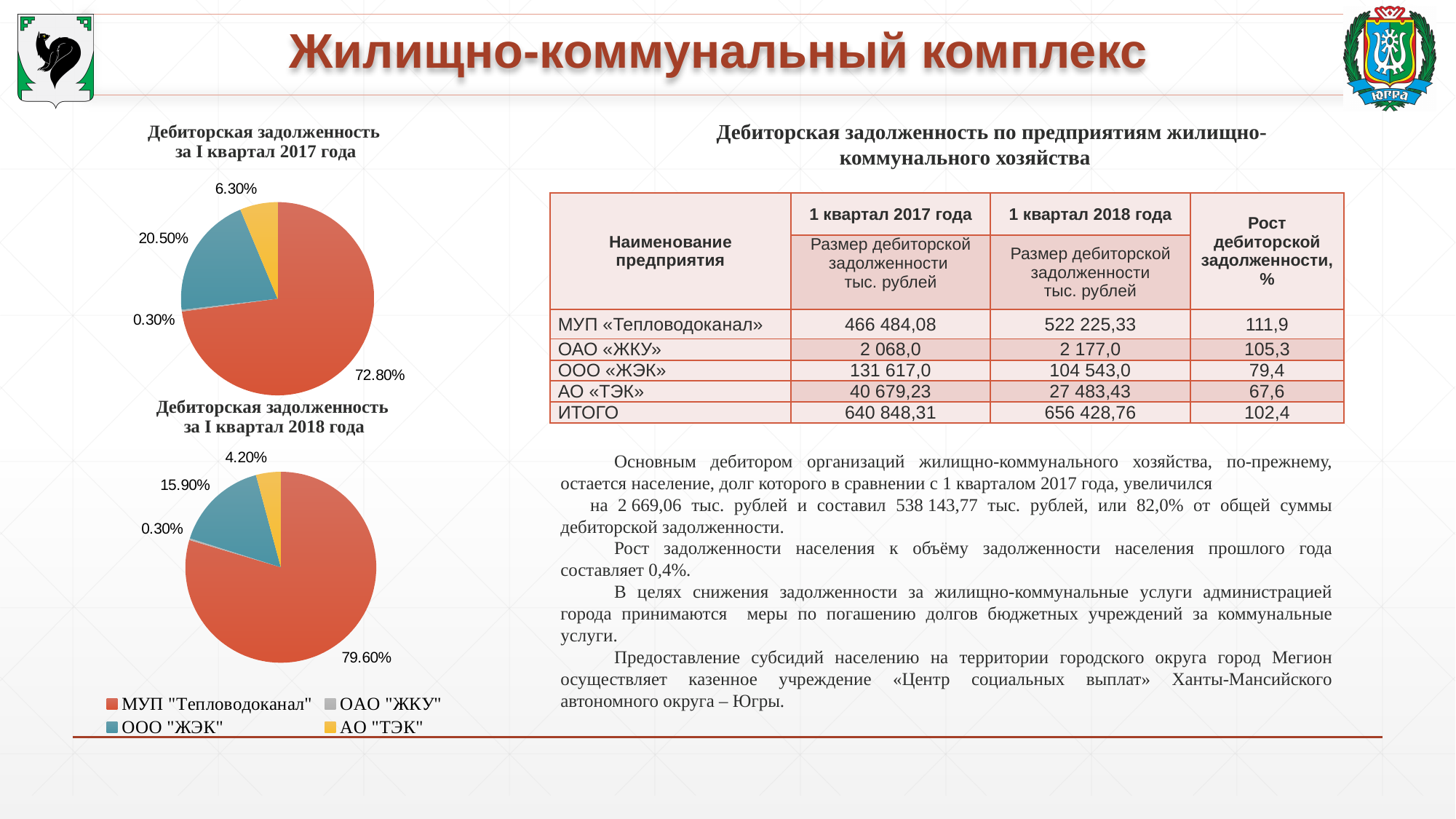
In the chart "Дебиторская задолженность за I квартал 2018 года", what share does ООО "ЖЭК" have? 15.90% In the chart "Дебиторская задолженность за I квартал 2018 года", which enterprise has the largest share? МУП "Тепловодоканал" In the chart "Дебиторская задолженность за I квартал 2017 года", what share does ООО "ЖЭК" have? 20.50% In the chart "Дебиторская задолженность за I квартал 2017 года", which enterprise has the smallest share? ОАО "ЖКУ" Comparing the two pie charts, is the share of МУП "Тепловодоканал" larger in the 2017 chart or the 2018 chart? 2018 chart In the chart "Дебиторская задолженность за I квартал 2017 года", what share does МУП "Тепловодоканал" have? 72.80% In the chart "Дебиторская задолженность за I квартал 2017 года", what is the difference between the shares of ООО "ЖЭК" and АО "ТЭК"? 14.20% In the chart "Дебиторская задолженность за I квартал 2018 года", which is larger: the share of ООО "ЖЭК" or the share of АО "ТЭК"? ООО "ЖЭК" What type of chart is "Дебиторская задолженность за I квартал 2018 года"? Pie chart How many slices does the chart "Дебиторская задолженность за I квартал 2017 года" have? 4 In the chart "Дебиторская задолженность за I квартал 2018 года", what share does АО "ТЭК" have? 4.20% In the shared legend of the pie charts, which enterprise is shown in yellow? АО "ТЭК"